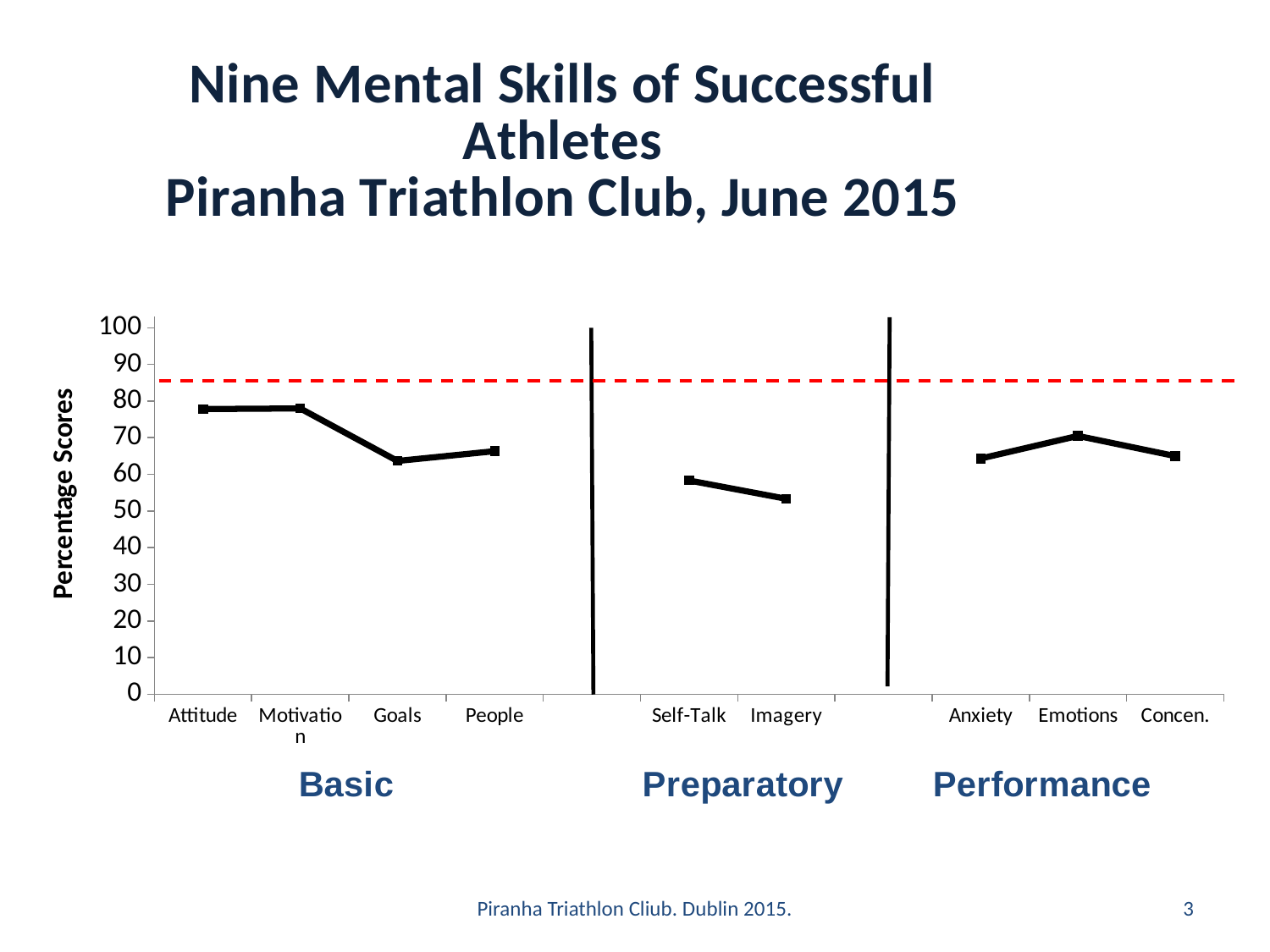
Is the value for Emotions greater or less than 60? greater Is the value for Goals greater or less than 70? less How many mental skills (categories) are plotted along the x axis? 9 What kind of chart is shown on the slide? line chart Which has the larger value, Anxiety or Emotions? Emotions Does the line rise or fall from Self-Talk to Imagery? fall Which has the larger value, Self-Talk or Imagery? Self-Talk Which mental skill has the lowest percentage score? Imagery What is the title of the vertical axis? Percentage Scores Is the value for Imagery greater or less than 60? less What are the three group labels shown beneath the x axis? Basic, Preparatory, Performance